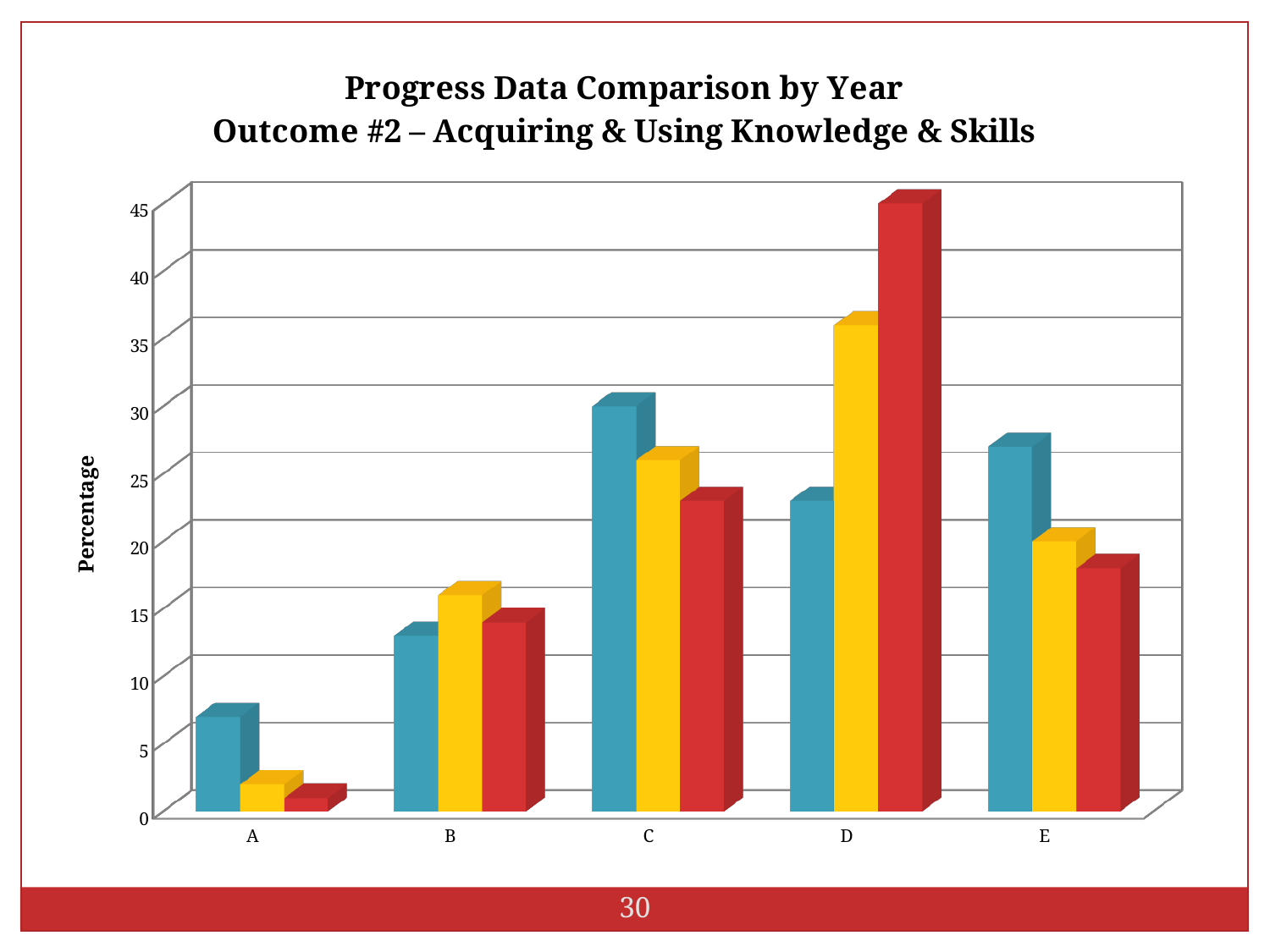
For category C, which is larger: the blue bar or the red bar? the blue bar Which category has the tallest blue bar? C What is the title of the vertical axis? Percentage For category D, which is larger: the yellow bar or the blue bar? the yellow bar Is the value of the blue bar for A greater or less than 10? less Which category has the tallest red bar? D Is the value of the yellow bar for C greater or less than 20? greater How many bars are plotted for each category? 3 What kind of chart is shown on the slide? bar chart How many categories are shown on the x axis? 5 Which category has the shortest blue bar? A Is the value of the red bar for D greater or less than 40? greater